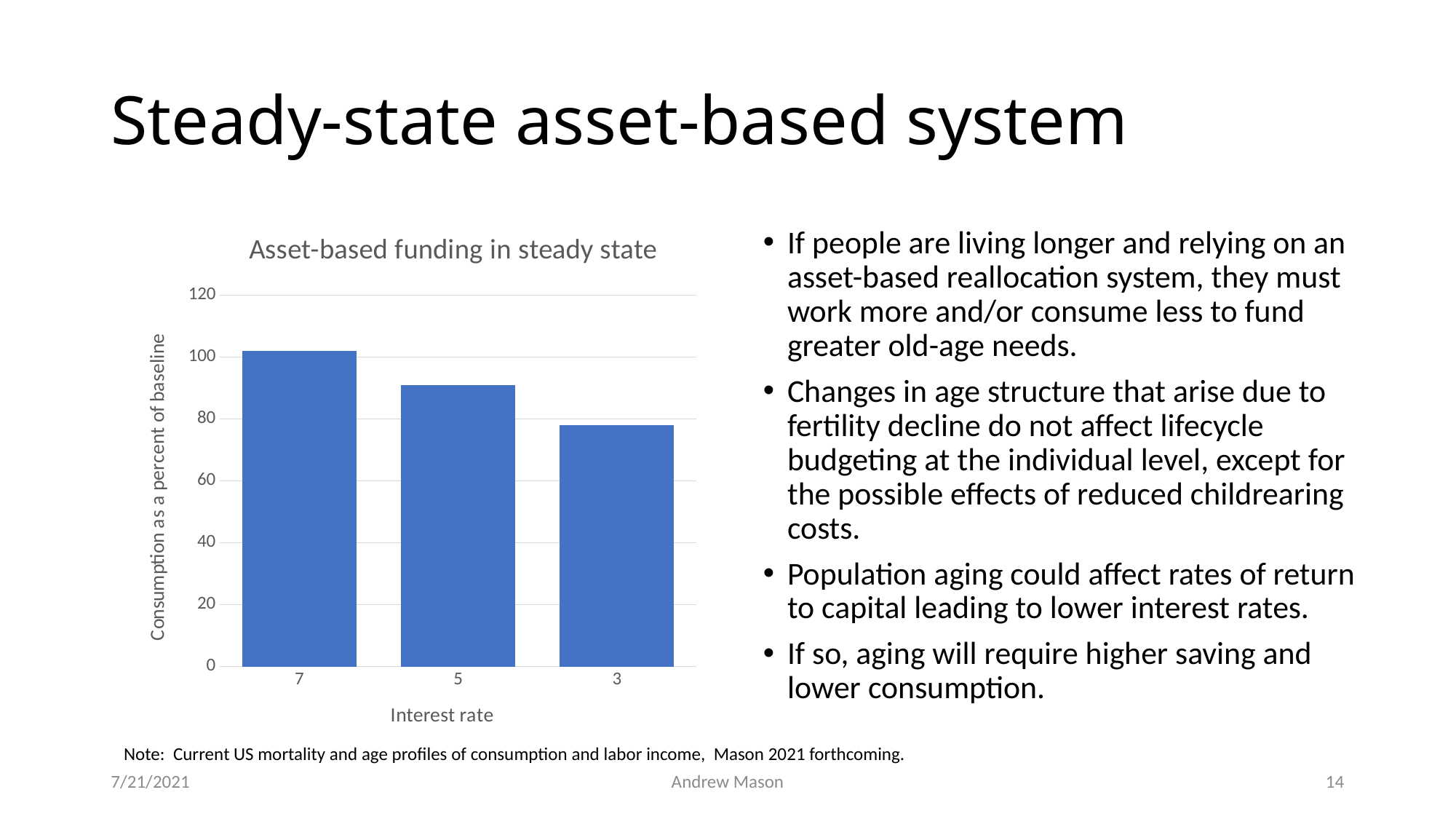
Do the bar values rise or fall moving from left to right along the x axis? fall Is the value for interest rate 3 greater or less than 60? greater What kind of chart is shown on the slide? bar chart Is the value for interest rate 3 greater or less than 100? less Which interest rate has the lowest consumption as a percent of baseline? 3 Which interest rate has the highest consumption as a percent of baseline? 7 Which has a higher consumption as a percent of baseline, interest rate 5 or interest rate 3? 5 Is the value for interest rate 5 greater or less than 100? less What is the label of the vertical axis of the chart? Consumption as a percent of baseline How many bars are plotted in the chart? 3 What is the title of the chart? Asset-based funding in steady state